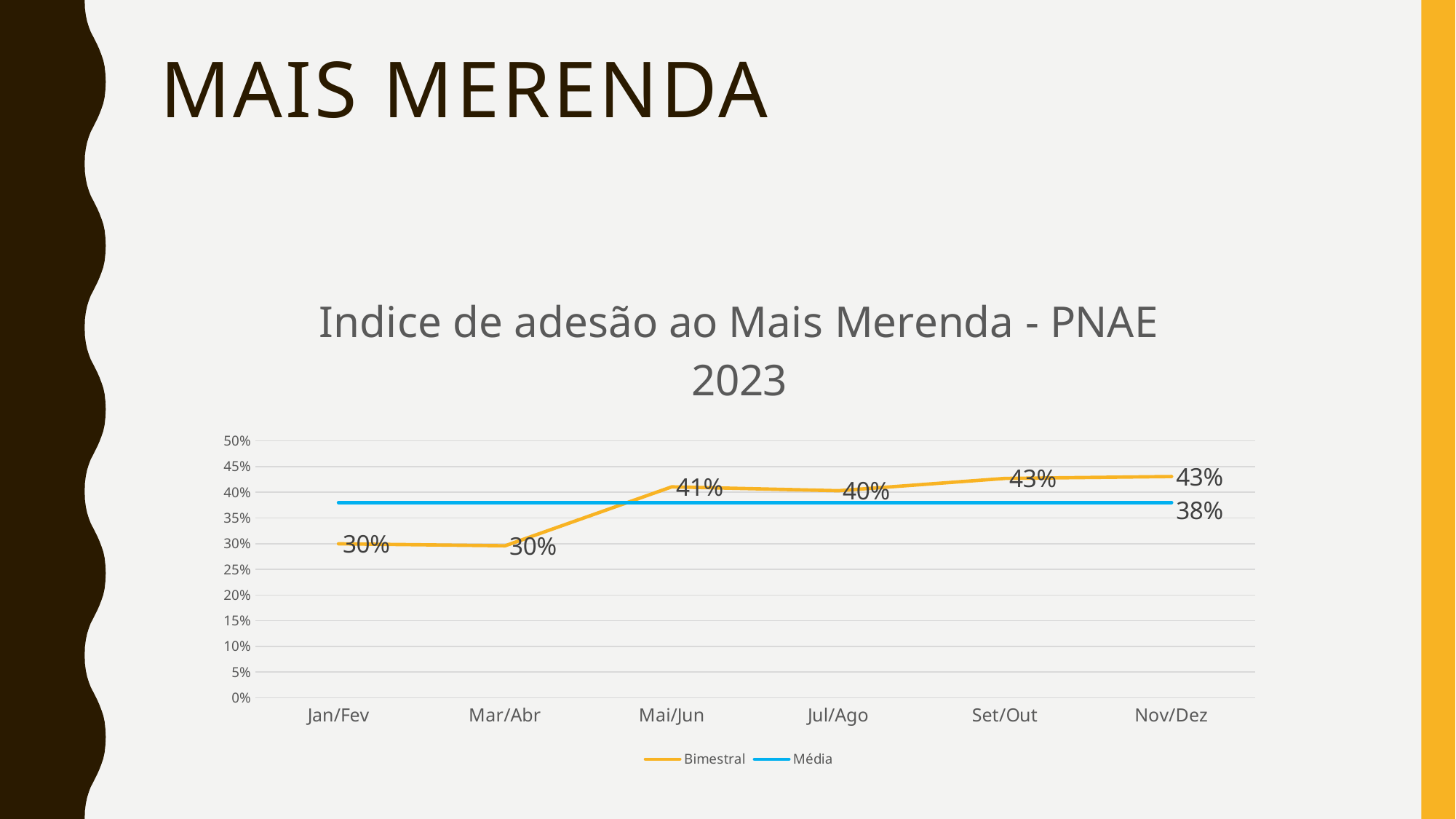
How many series does the legend list? 2 What is the Bimestral value for Set/Out? 43% How many periods are shown on the x axis? 6 What is the difference between the Bimestral values for Mai/Jun and Mar/Abr? 11 percentage points Does the Bimestral series rise or fall from Jan/Fev to Nov/Dez? rise What is the Bimestral value for Jan/Fev? 30% What is the Bimestral value for Mai/Jun? 41% Is the Bimestral value for Mar/Abr greater or less than 35%? less What is the value of the Média line? 38% What kind of chart is shown? line chart What is the difference between the Bimestral value for Nov/Dez and the Média value? 5 percentage points Which is larger, the Bimestral value for Mai/Jun or for Jul/Ago? Mai/Jun